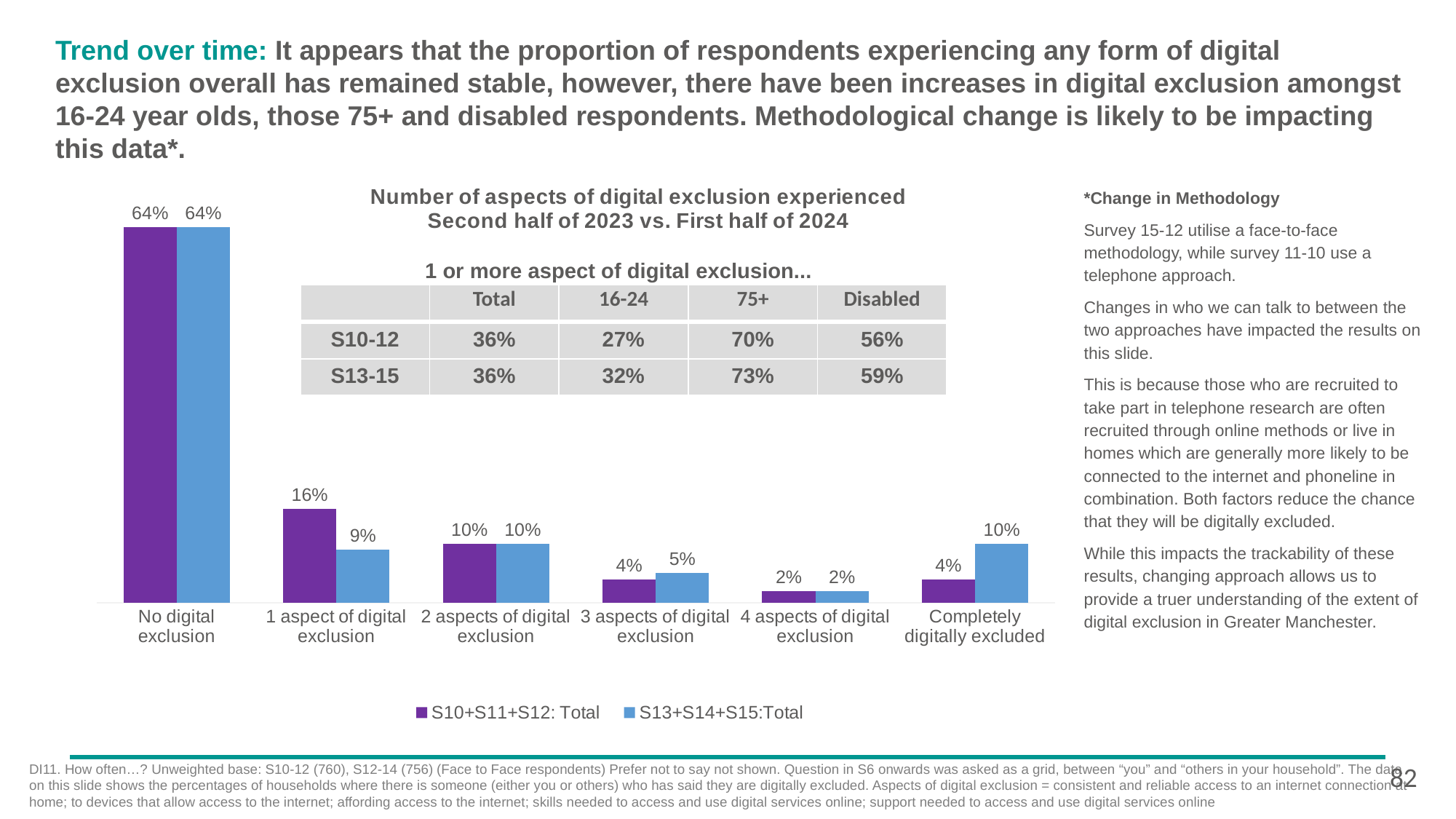
What is the difference between the S10+S11+S12: Total and S13+S14+S15:Total values for '1 aspect of digital exclusion'? 7% Which category has the highest value in the S13+S14+S15:Total series? No digital exclusion What is the title of the chart? Number of aspects of digital exclusion experienced Second half of 2023 vs. First half of 2024 What is the value for 'Completely digitally excluded' in the S13+S14+S15:Total series? 10% What kind of chart is shown on the slide? Bar chart Which category has the lowest value in the S10+S11+S12: Total series? 4 aspects of digital exclusion What is the value for '3 aspects of digital exclusion' in the S10+S11+S12: Total series? 4% What is the value for 'No digital exclusion' in the S10+S11+S12: Total series? 64% How many categories are shown on the x axis of the chart? 6 What is the value for '1 aspect of digital exclusion' in the S13+S14+S15:Total series? 9% For 'Completely digitally excluded', which series has the larger value, S10+S11+S12: Total or S13+S14+S15:Total? S13+S14+S15:Total How many series does the legend list? 2